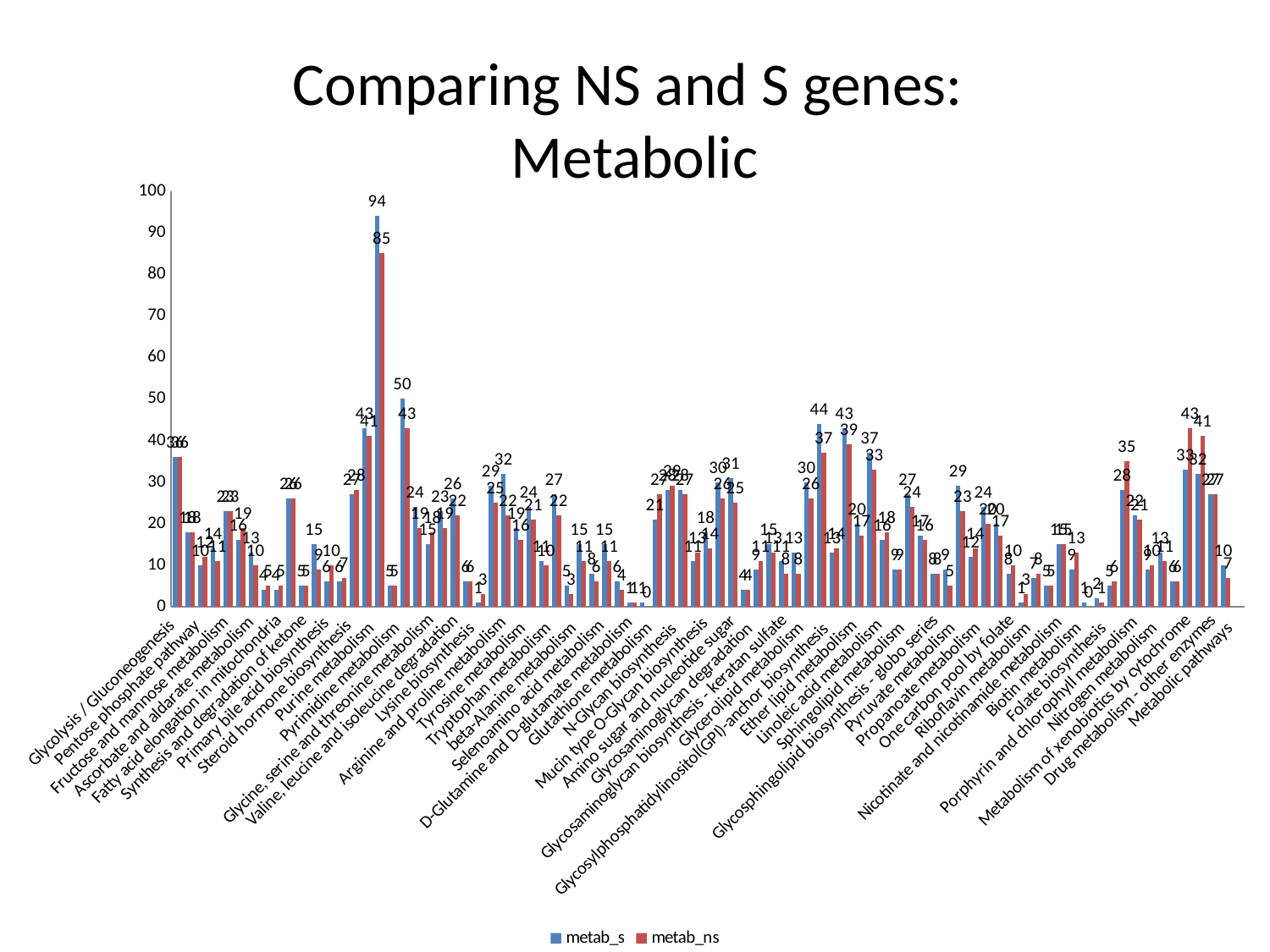
What is the difference between the metab_s and metab_ns values for Purine metabolism? 9 What kind of chart is shown on the slide? bar chart What is the metab_ns value for Purine metabolism? 85 Is the metab_s value for Pyrimidine metabolism greater or less than 40? greater For Purine metabolism, which series has the larger value, metab_s or metab_ns? metab_s What is the title of the chart? Comparing NS and S genes: Metabolic What is the metab_s value for Purine metabolism? 94 What are the two series named in the legend? metab_s and metab_ns Which category has the highest metab_s value? Purine metabolism What is the metab_s value for Glycolysis / Gluconeogenesis? 36 How many series does the legend list? 2 Is the metab_ns value for Purine metabolism greater or less than 80? greater